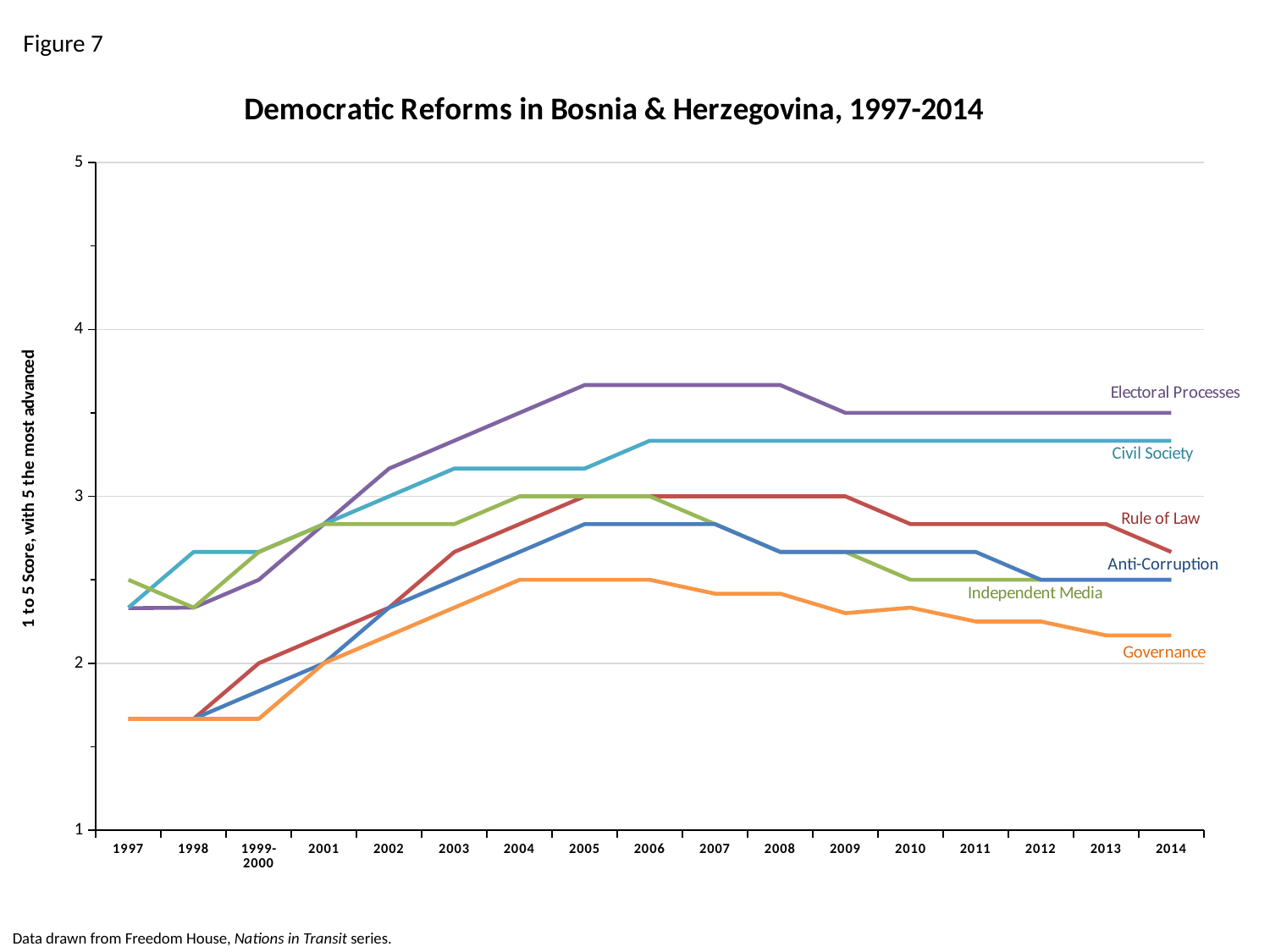
Is the value for Anti-Corruption in 2014 greater or less than 3? less Which series has the highest value in 2014? Electoral Processes How many series are labelled on the chart? 6 What is the title of the chart? Democratic Reforms in Bosnia & Herzegovina, 1997-2014 How many time periods are shown on the x axis? 17 Does the Governance line rise or fall from 2006 to 2014? fall Does the Electoral Processes line rise or fall from 1997 to 2005? rise Is the value for Electoral Processes in 2005 greater or less than 3.5? greater Which series has the lowest value in 2014? Governance In 2014, which is larger: Civil Society or Rule of Law? Civil Society What kind of chart is shown on the slide? line chart Is the value for Governance in 1997 greater or less than 2? less